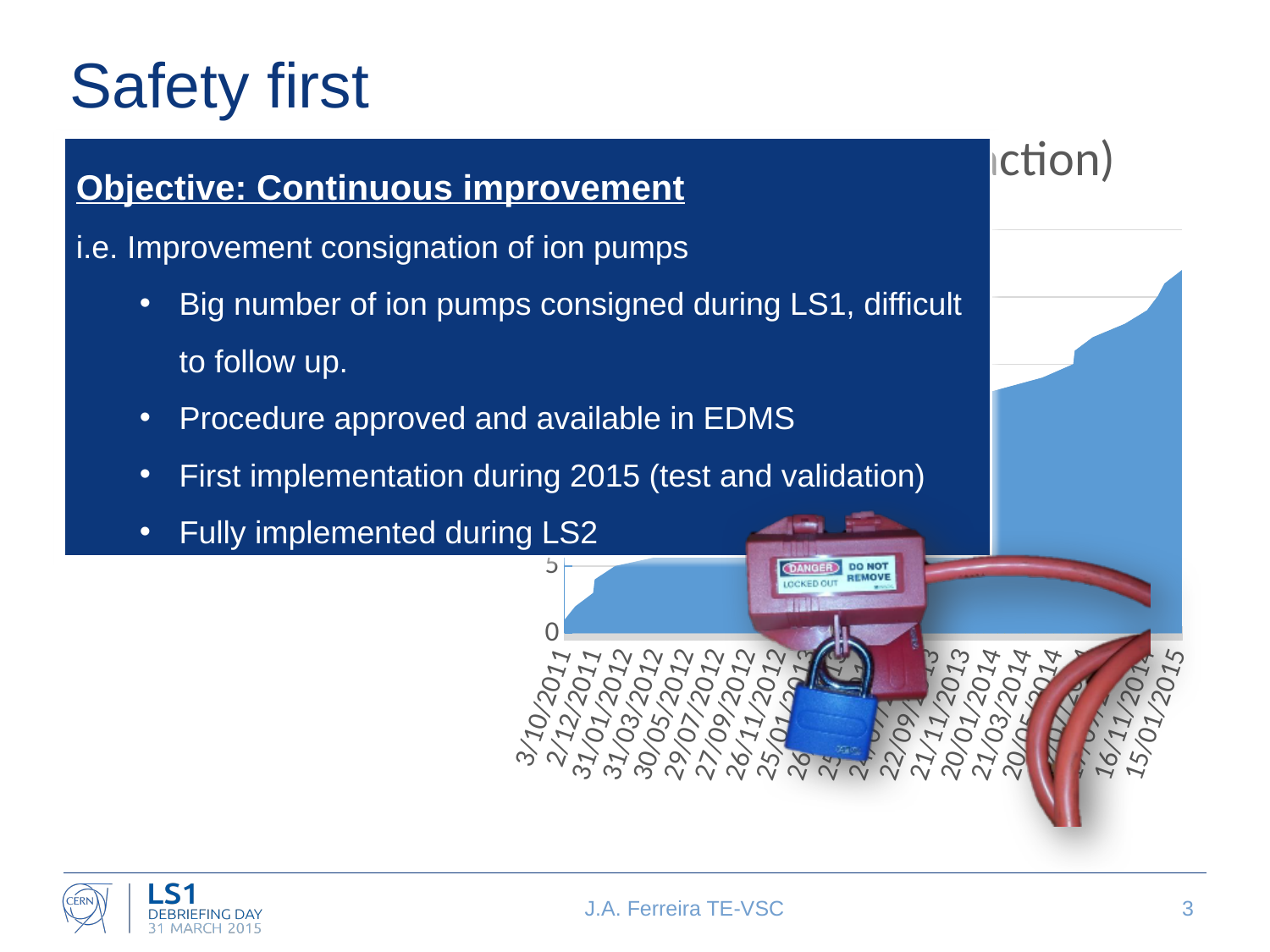
Is the value for 3/10/2011 greater or less than 5? less What kind of chart is shown on the slide? area chart Is the value for 15/01/2015 greater or less than 5? greater Do the plotted values rise or fall along the x axis from 3/10/2011 to 15/01/2015? rise What is the first date label on the x axis? 3/10/2011 What is the last date label on the x axis? 15/01/2015 Which of 3/10/2011 and 15/01/2015 has the larger value? 15/01/2015